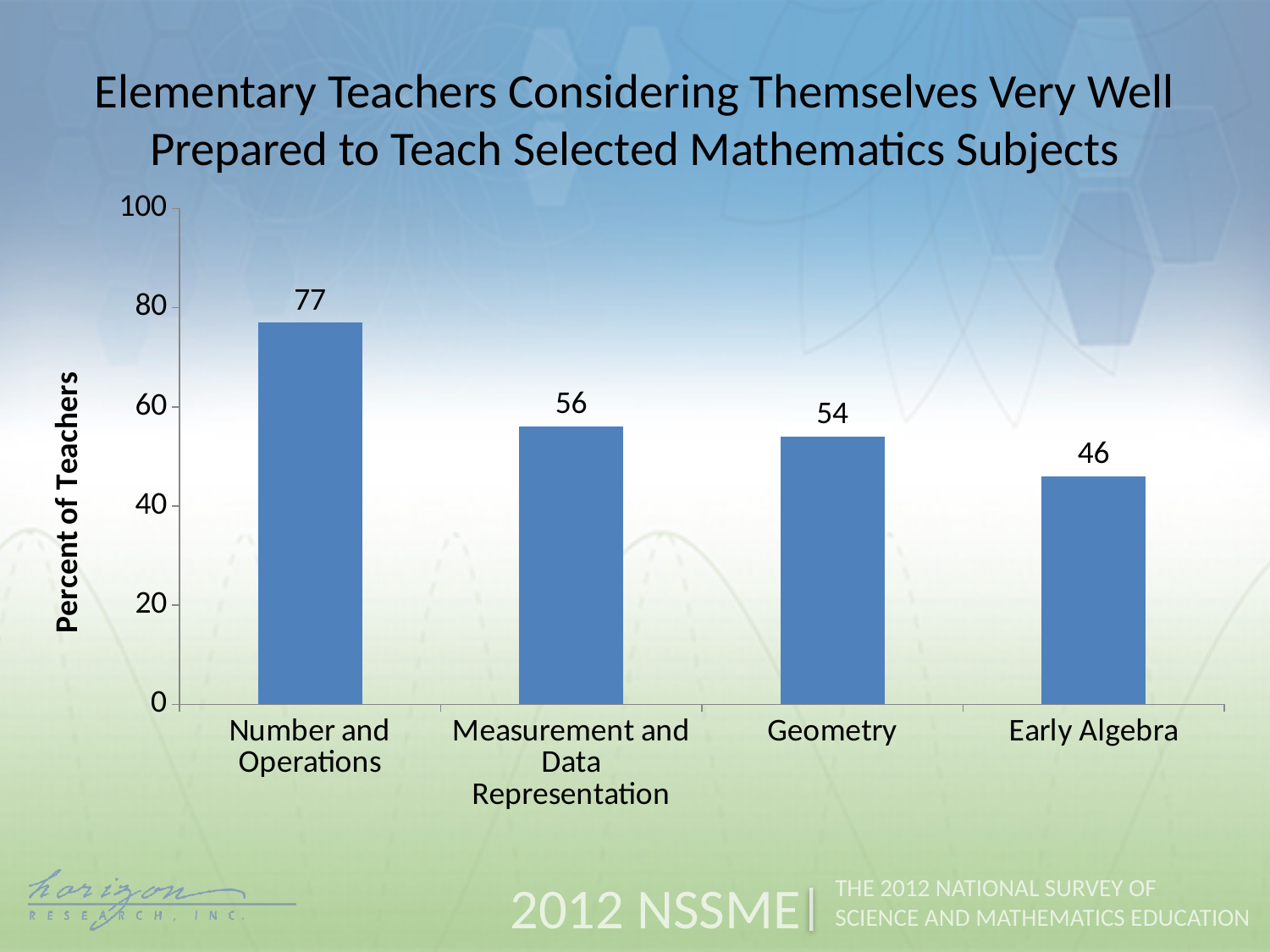
What is the value shown for Geometry? 54 What is the difference between the values for Number and Operations and Early Algebra? 31 Which subject has the highest percent of teachers? Number and Operations How many subjects are shown on the chart? 4 Which is larger, the value for Geometry or the value for Early Algebra? Geometry Which subject has the lowest percent of teachers? Early Algebra What is the value shown for Measurement and Data Representation? 56 What is the label of the vertical axis? Percent of Teachers What is the value shown for Early Algebra? 46 What is the difference between the values for Measurement and Data Representation and Geometry? 2 What kind of chart is shown on the slide? Bar chart What percent of teachers considered themselves very well prepared to teach Number and Operations? 77